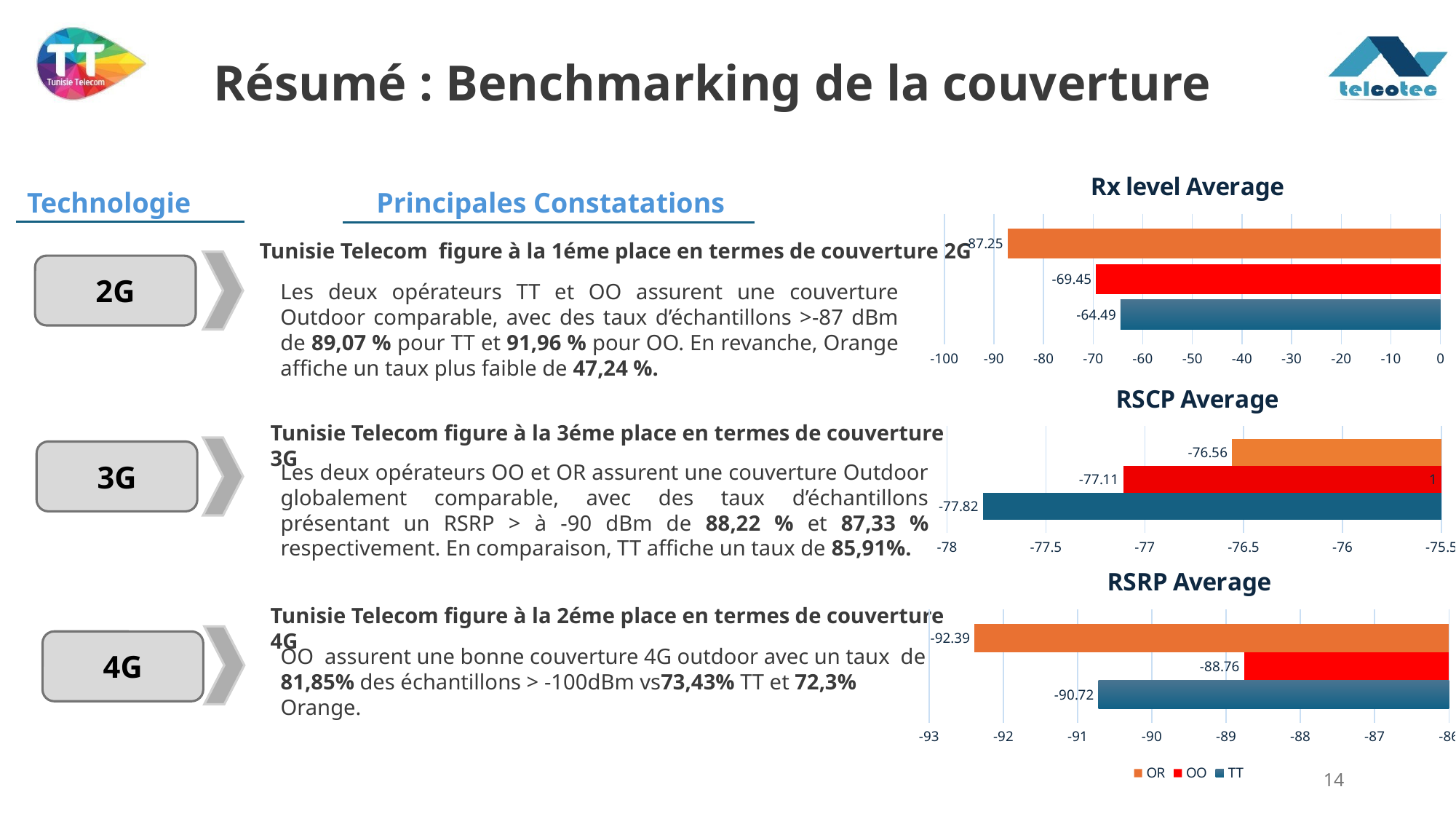
In the Rx level Average chart, what is the value for OO? -69.45 In the RSCP Average chart, what is the value for OR? -76.56 In the RSRP Average chart, what is the value for OR? -92.39 In the Rx level Average chart, which operator has the highest value? TT In the RSCP Average chart, which operator has the lowest value? TT In the RSCP Average chart, which is larger, the value for OR or the value for OO? OR In the RSRP Average chart, what is the value for OO? -88.76 In the RSRP Average chart, what is the difference between the values for OO and TT? 1.96 How many series does the legend at the bottom of the slide list? 3 In the Rx level Average chart, is the value for OR greater or less than -80? less In the RSCP Average chart, what is the value for TT? -77.82 In the Rx level Average chart, what is the value for TT? -64.49